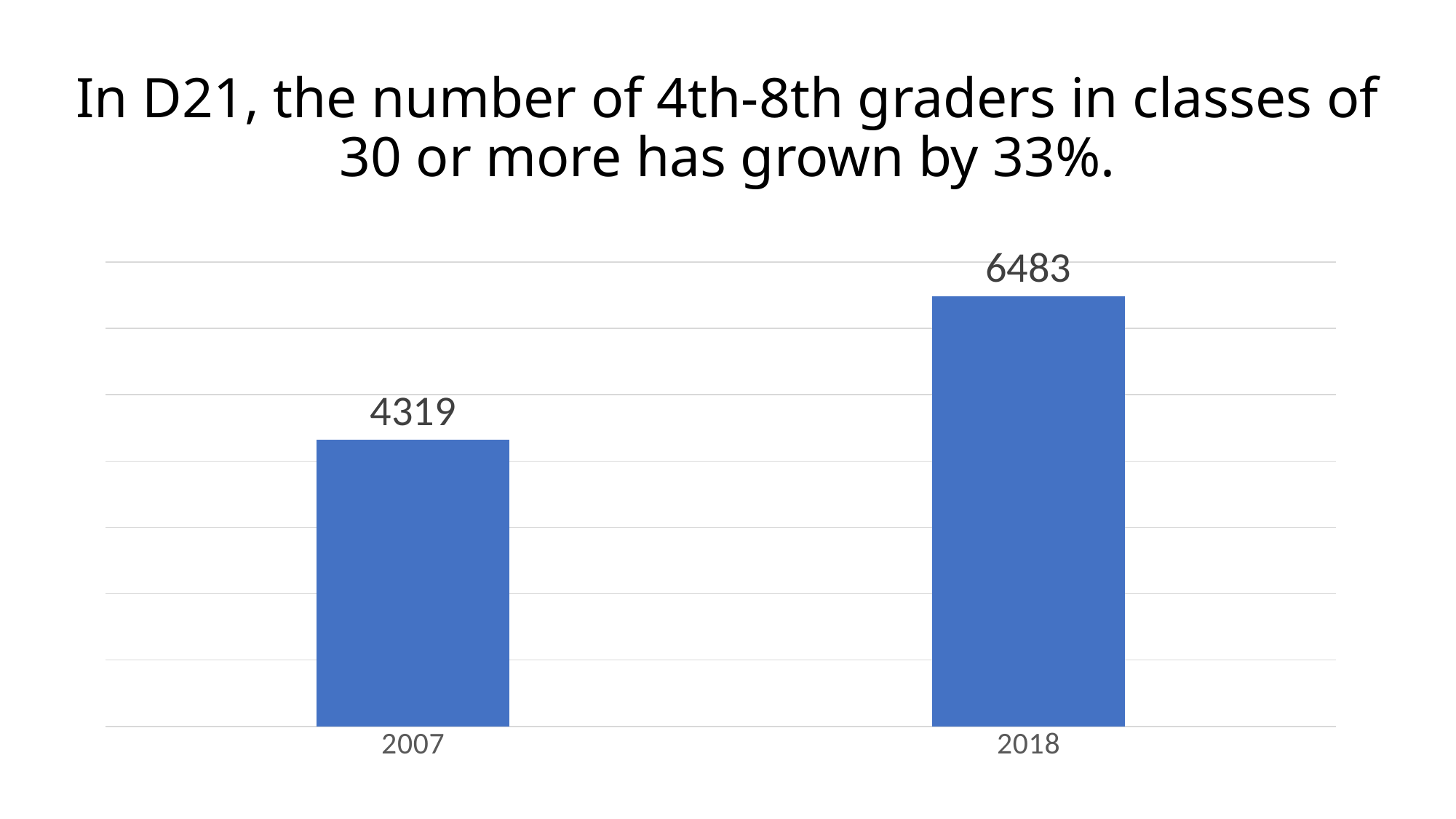
How many bars are shown in the chart? 2 What is the difference between the values for 2018 and 2007? 2164 Which year has the lowest value? 2007 What colour are the bars in the chart? blue What is the value for 2018? 6483 What is the value for 2007? 4319 What kind of chart is shown on the slide? bar chart What is the title of the slide? In D21, the number of 4th-8th graders in classes of 30 or more has grown by 33%. Which is larger, the value for 2007 or the value for 2018? 2018 Do the values rise or fall from 2007 to 2018? rise Which year has the highest value? 2018